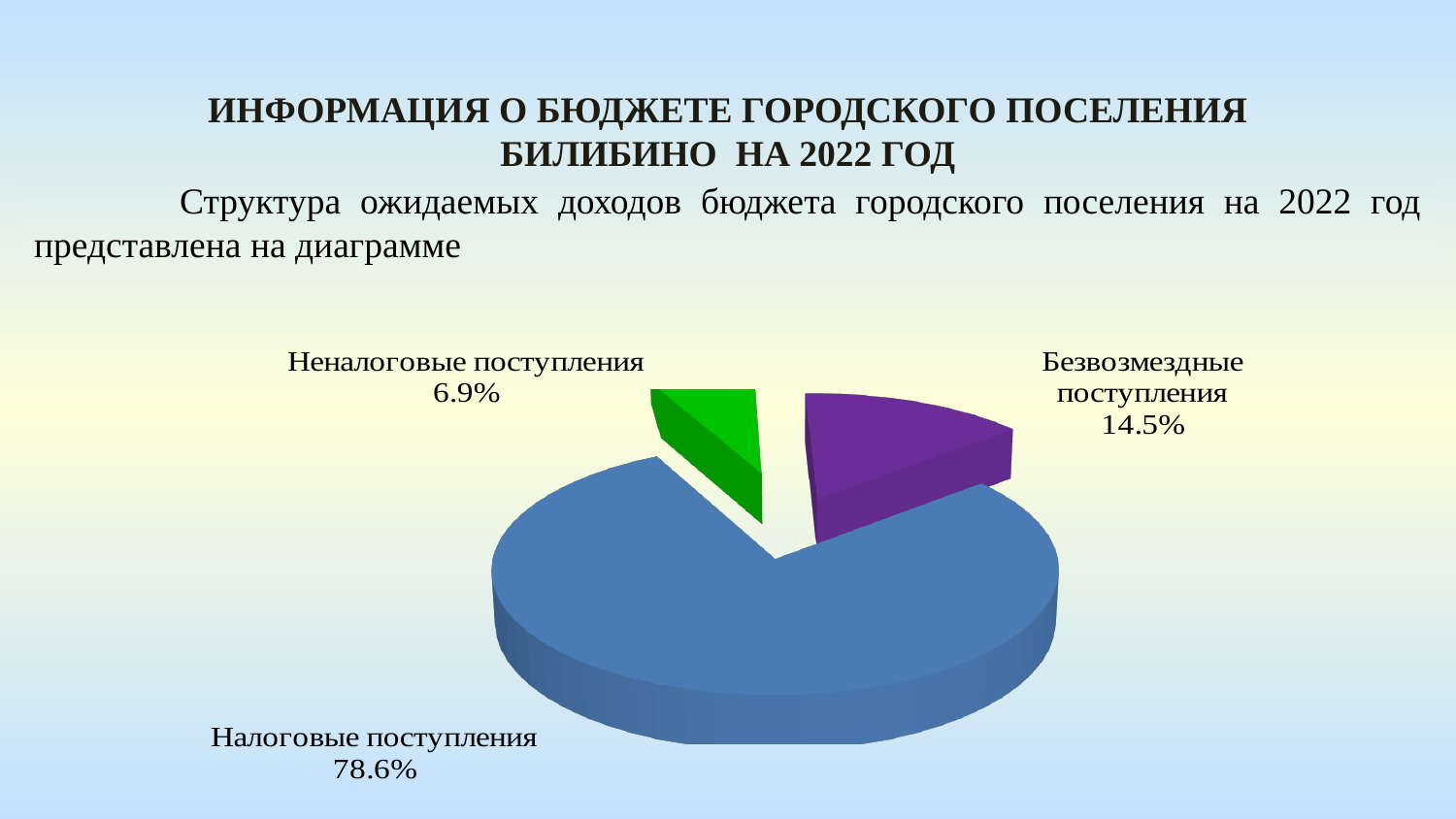
Which category has the smallest slice of the pie? Неналоговые поступления What is the value shown for Безвозмездные поступления? 14.5% What is the difference between the shares of Налоговые поступления and Безвозмездные поступления? 64.1% What share of the pie does Налоговые поступления represent? 78.6% What is the value shown for Неналоговые поступления? 6.9% What colour is the slice for Безвозмездные поступления? Purple Which is larger: the share of Безвозмездные поступления or Неналоговые поступления? Безвозмездные поступления Which category has the largest slice of the pie? Налоговые поступления What kind of chart is shown on the slide? Pie chart What colour is the slice for Неналоговые поступления? Green What is the difference between the shares of Безвозмездные поступления and Неналоговые поступления? 7.6% How many slices does the pie chart have? 3